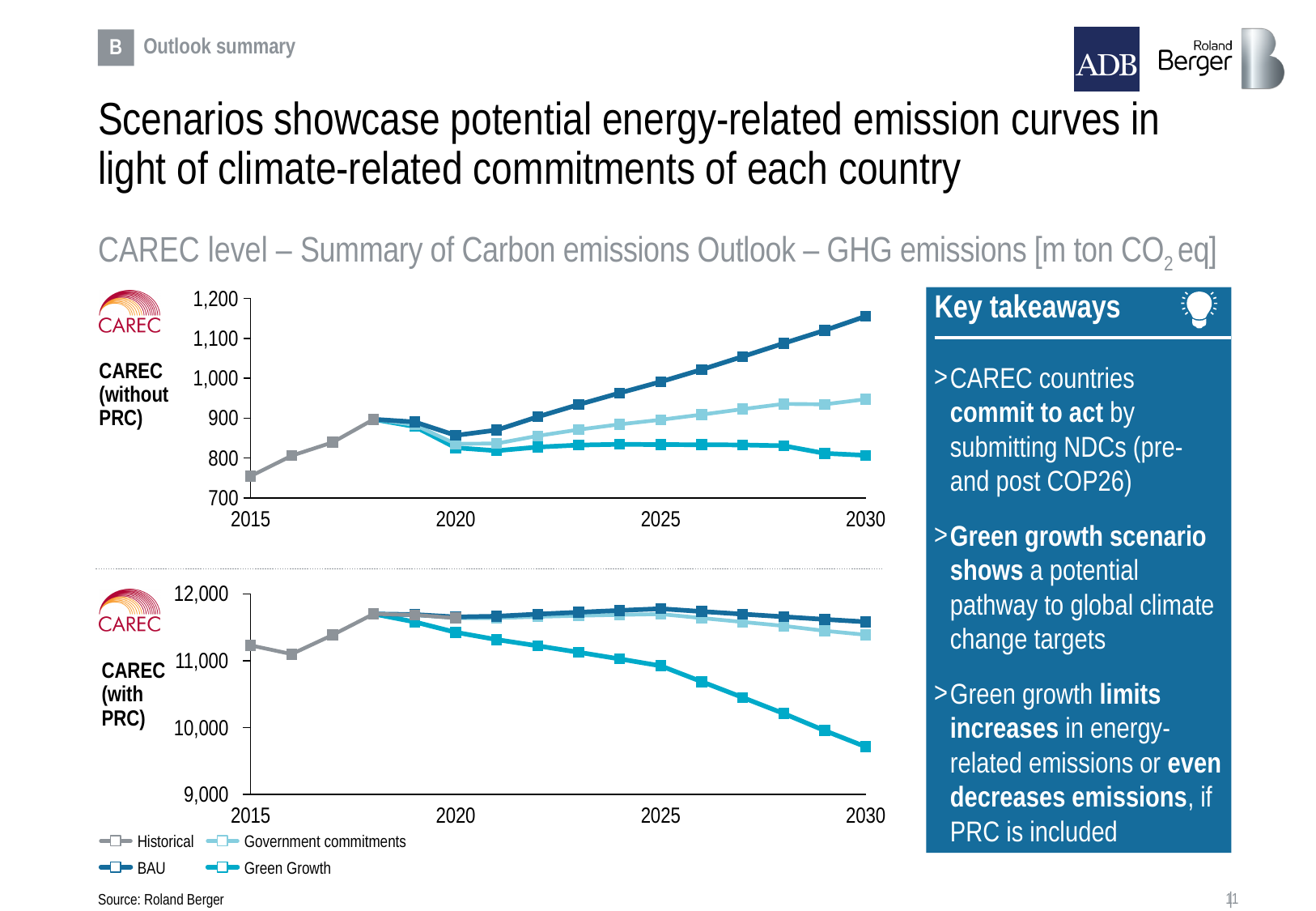
In the top chart (CAREC without PRC), is the Historical value in 2015 greater or less than 800? less In the bottom chart (CAREC with PRC), which series has the lowest value in 2030? Green Growth In the bottom chart (CAREC with PRC), does the Green Growth series rise or fall from 2020 to 2030? fall In the bottom chart (CAREC with PRC), is the BAU value in 2030 greater or less than 11,000? greater What kind of chart is the top chart, CAREC (without PRC)? line chart In the top chart (CAREC without PRC), which series has the highest value in 2030? BAU What unit of measurement is given in the chart title for GHG emissions? m ton CO2 eq How many series does the legend list for the charts? 4 In the top chart (CAREC without PRC), is the BAU value in 2030 greater or less than 1,100? greater In the top chart (CAREC without PRC), does the BAU series rise or fall from 2020 to 2030? rise